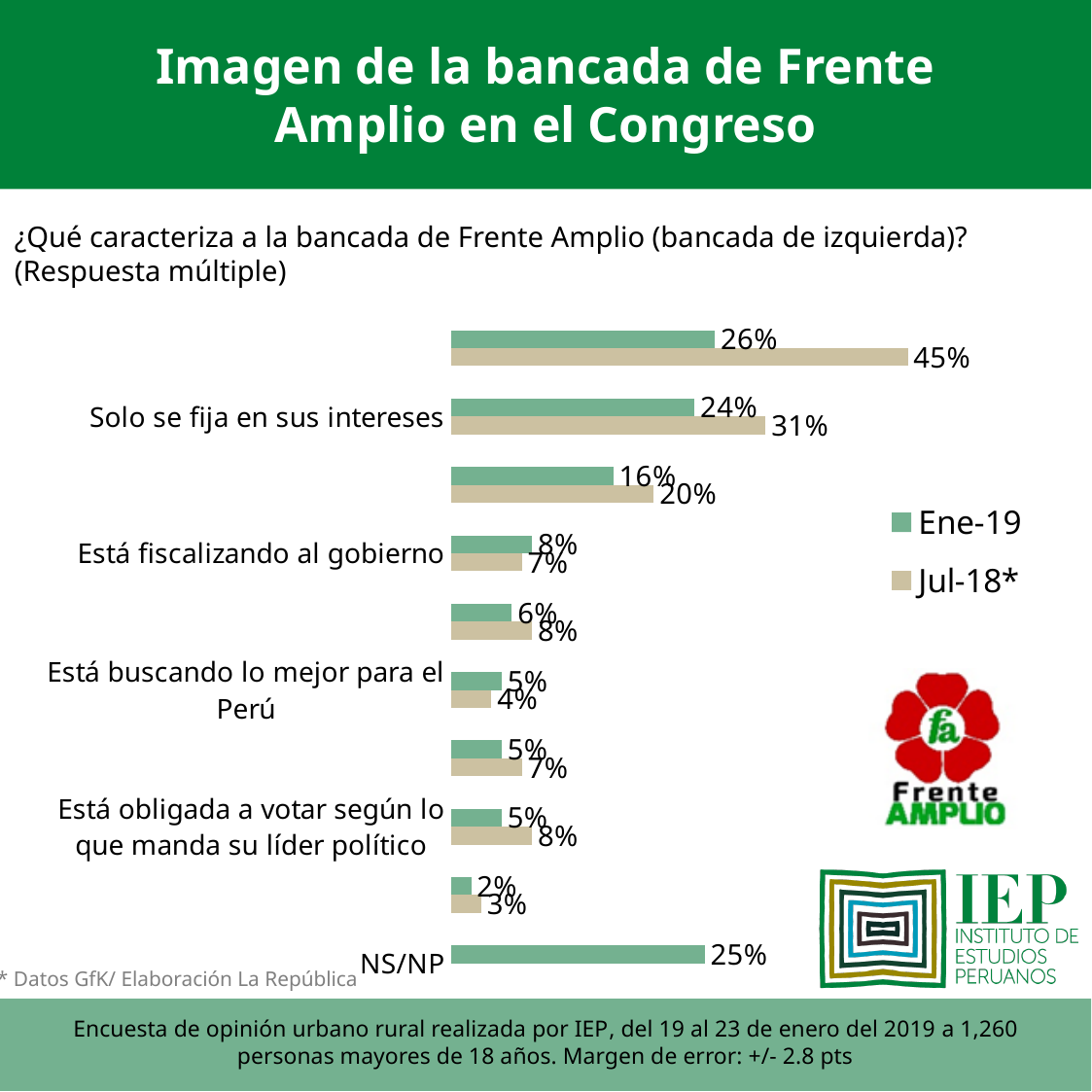
What is the Jul-18* value for 'Está obligada a votar según lo que manda su líder político'? 8% What is the Jul-18* value for 'Solo se fija en sus intereses'? 31% What kind of chart is shown on the slide? bar chart What is the difference between the Jul-18* and Ene-19 values for 'Solo se fija en sus intereses'? 7% How many series does the legend list? 2 What is the Ene-19 value for 'Está fiscalizando al gobierno'? 8% For 'Está buscando lo mejor para el Perú', which series has the larger value, Ene-19 or Jul-18*? Ene-19 How many category groups of bars are plotted in the chart? 10 What are the two series named in the legend? Ene-19 and Jul-18* What is the Ene-19 value for NS/NP? 25% What is the highest Jul-18* value shown in the chart? 45% What is the Ene-19 value for 'Solo se fija en sus intereses'? 24%